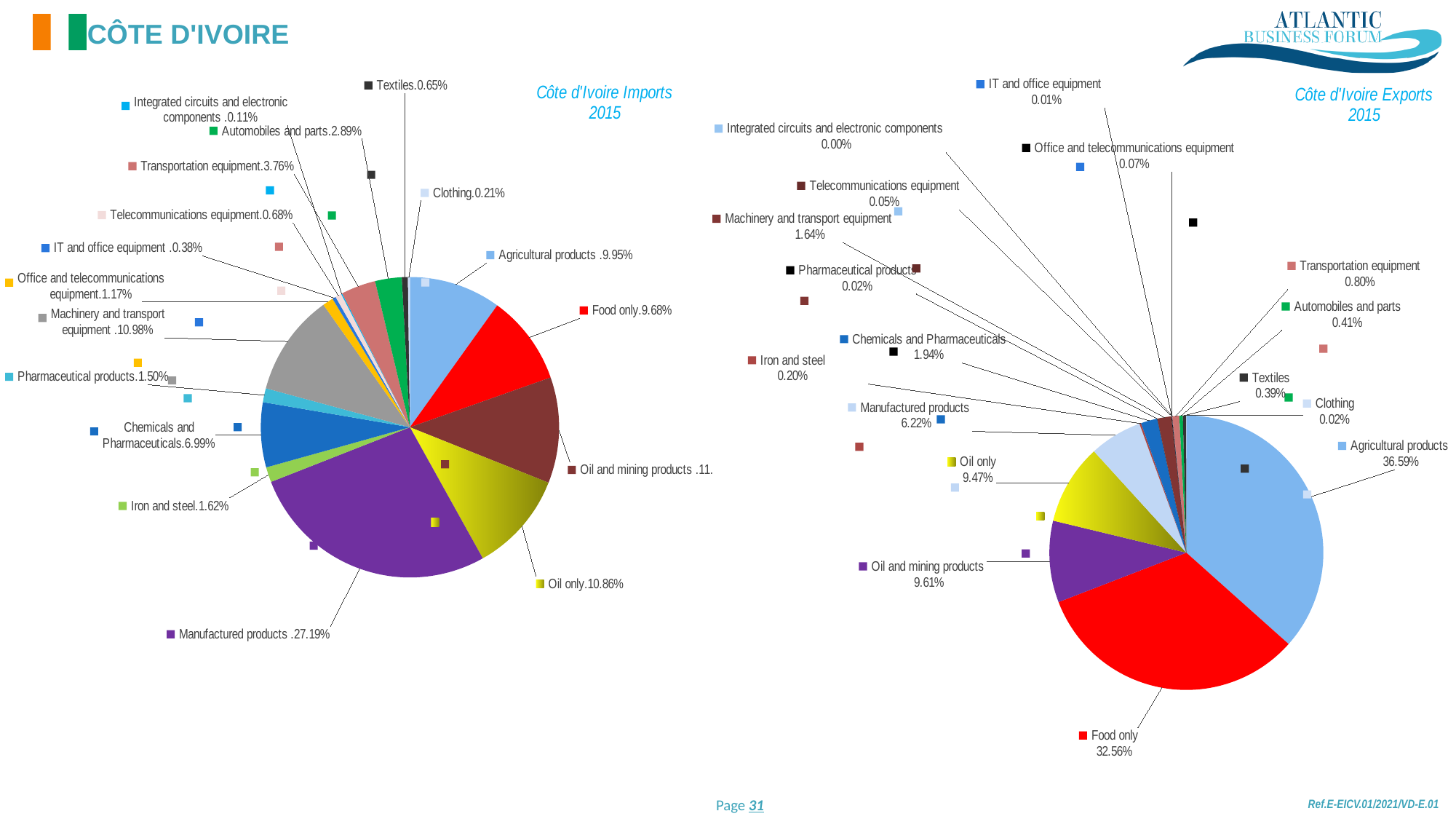
In the Côte d'Ivoire Exports 2015 chart, what is the share for Food only? 32.56% In the Côte d'Ivoire Exports 2015 chart, what is the difference between the shares of Agricultural products and Food only? 4.03% In the Côte d'Ivoire Imports 2015 chart, what share do Manufactured products have? 27.19% In the Côte d'Ivoire Exports 2015 chart, which category has the largest share? Agricultural products What type of chart is used for Côte d'Ivoire Exports 2015? Pie chart In the Côte d'Ivoire Imports 2015 chart, which category has the smallest share? Integrated circuits and electronic components In the Côte d'Ivoire Exports 2015 chart, what is the share for Manufactured products? 6.22% In the Côte d'Ivoire Exports 2015 chart, what share do Agricultural products have? 36.59% In the Côte d'Ivoire Imports 2015 chart, what is the share for Oil only? 10.86% In the Côte d'Ivoire Imports 2015 chart, which is larger: Agricultural products or Food only? Agricultural products In the Côte d'Ivoire Exports 2015 chart, which category has the smallest share? Integrated circuits and electronic components In the Côte d'Ivoire Imports 2015 chart, which category has the largest share? Manufactured products